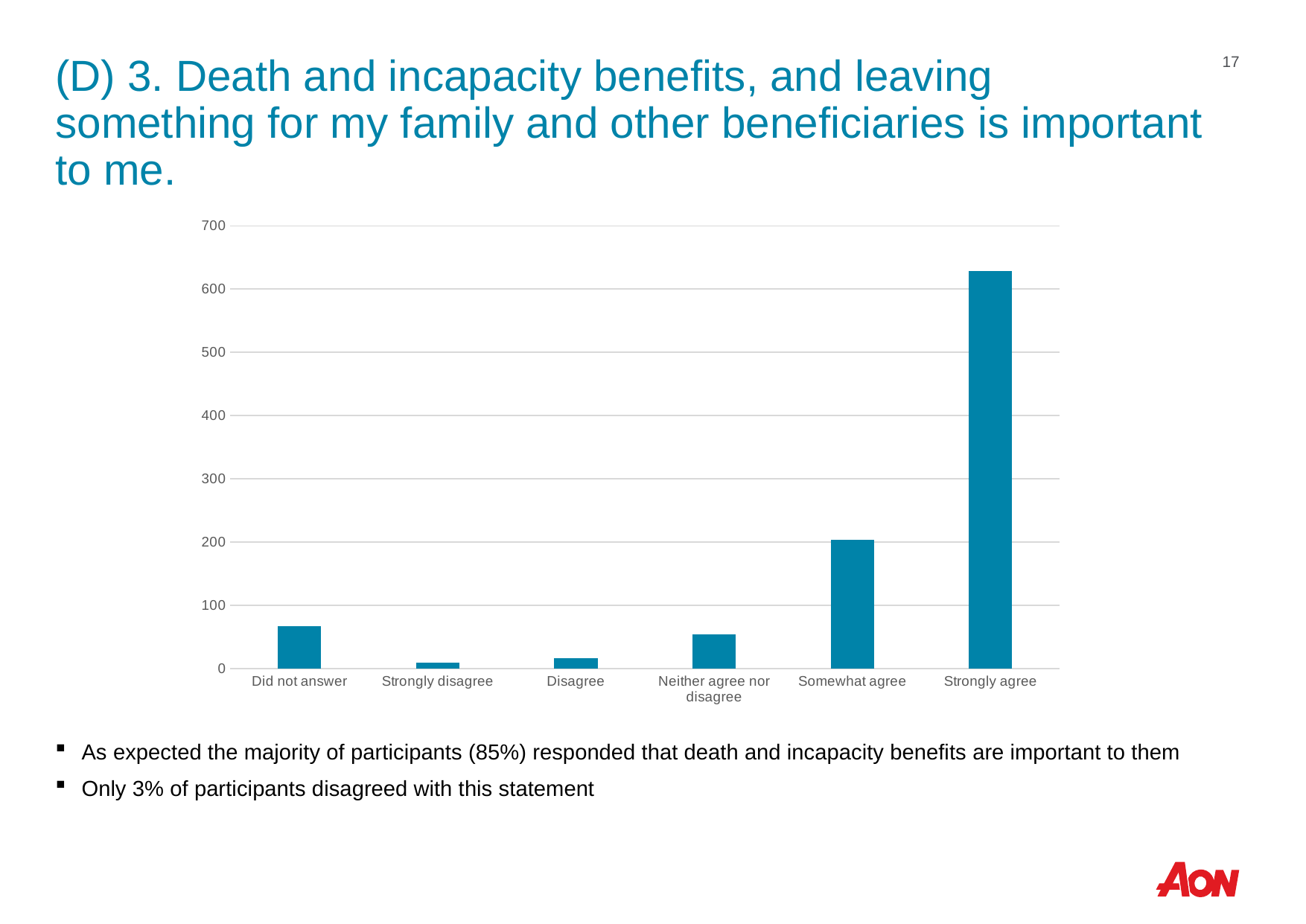
Is the value for Somewhat agree greater or less than 300? less What kind of chart is shown on the slide? bar chart Is the value for Neither agree nor disagree greater or less than 100? less How many response categories are shown on the x axis of the chart? 6 Which is larger, the value for Did not answer or the value for Neither agree nor disagree? Did not answer Is the value for Did not answer greater or less than 100? less Which response category has the lowest bar? Strongly disagree Which response category has the highest bar? Strongly agree What is the highest value shown on the y axis of the chart? 700 Which is larger, the value for Somewhat agree or the value for Strongly agree? Strongly agree